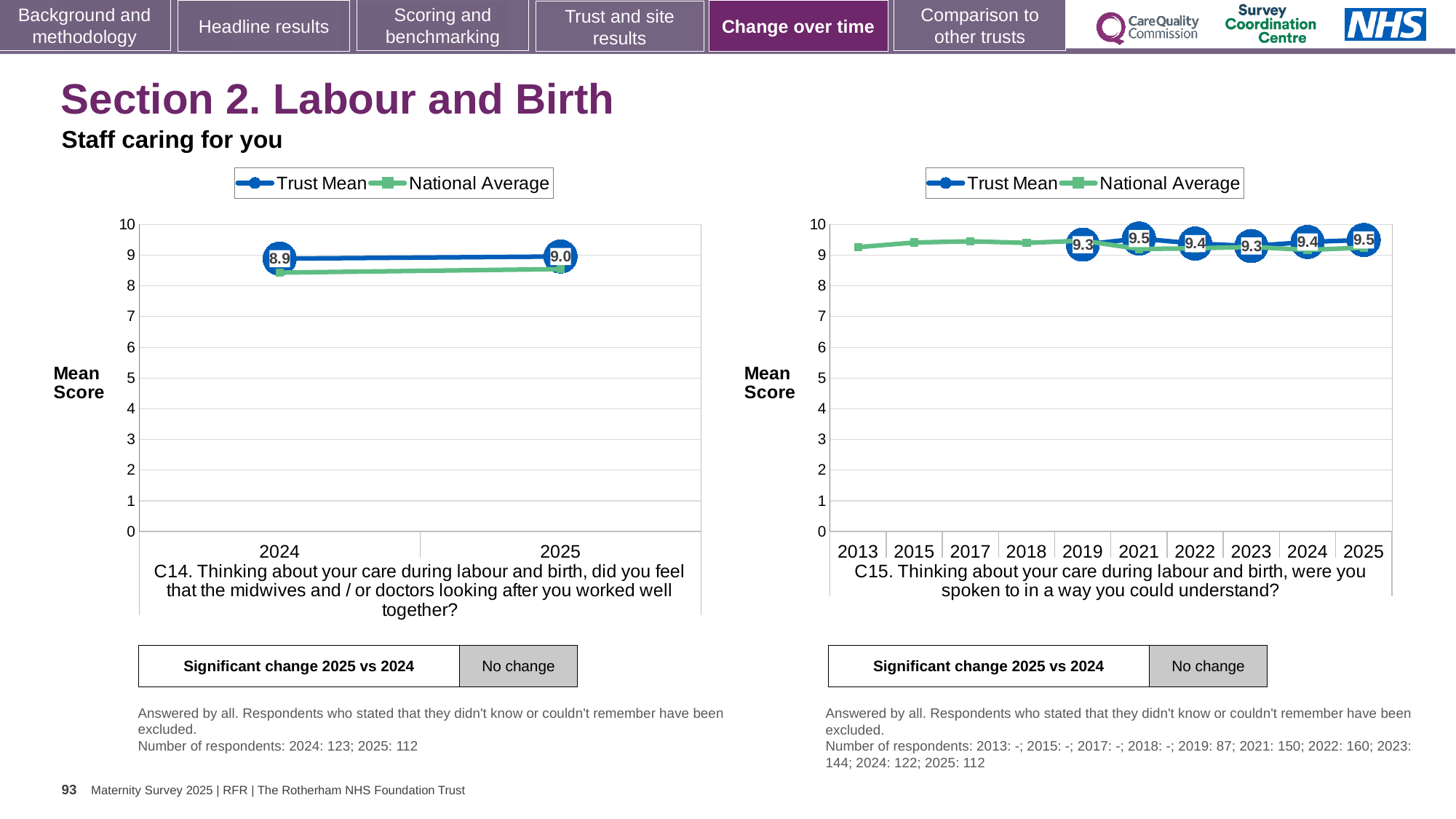
On the left chart (C14), by how much did the Trust Mean change from 2024 to 2025? 0.1 On the right chart (C15), what is the Trust Mean score for 2019? 9.3 On the left chart (C14), what is the Trust Mean score for 2025? 9.0 How many series does the legend of the right chart (C15) list? 2 On the right chart (C15), what is the Trust Mean score for 2021? 9.5 What kind of chart is the left chart (C14)? line chart On the right chart (C15), what is the Trust Mean score for 2023? 9.3 On the left chart (C14), what is the Trust Mean score for 2024? 8.9 On the left chart (C14), is the National Average value for 2024 greater or less than 9? less On the right chart (C15), how many years are shown on the x axis? 10 On the left chart (C14), does the Trust Mean rise or fall from 2024 to 2025? rise On the right chart (C15), which is larger: the Trust Mean for 2021 or for 2022? 2021